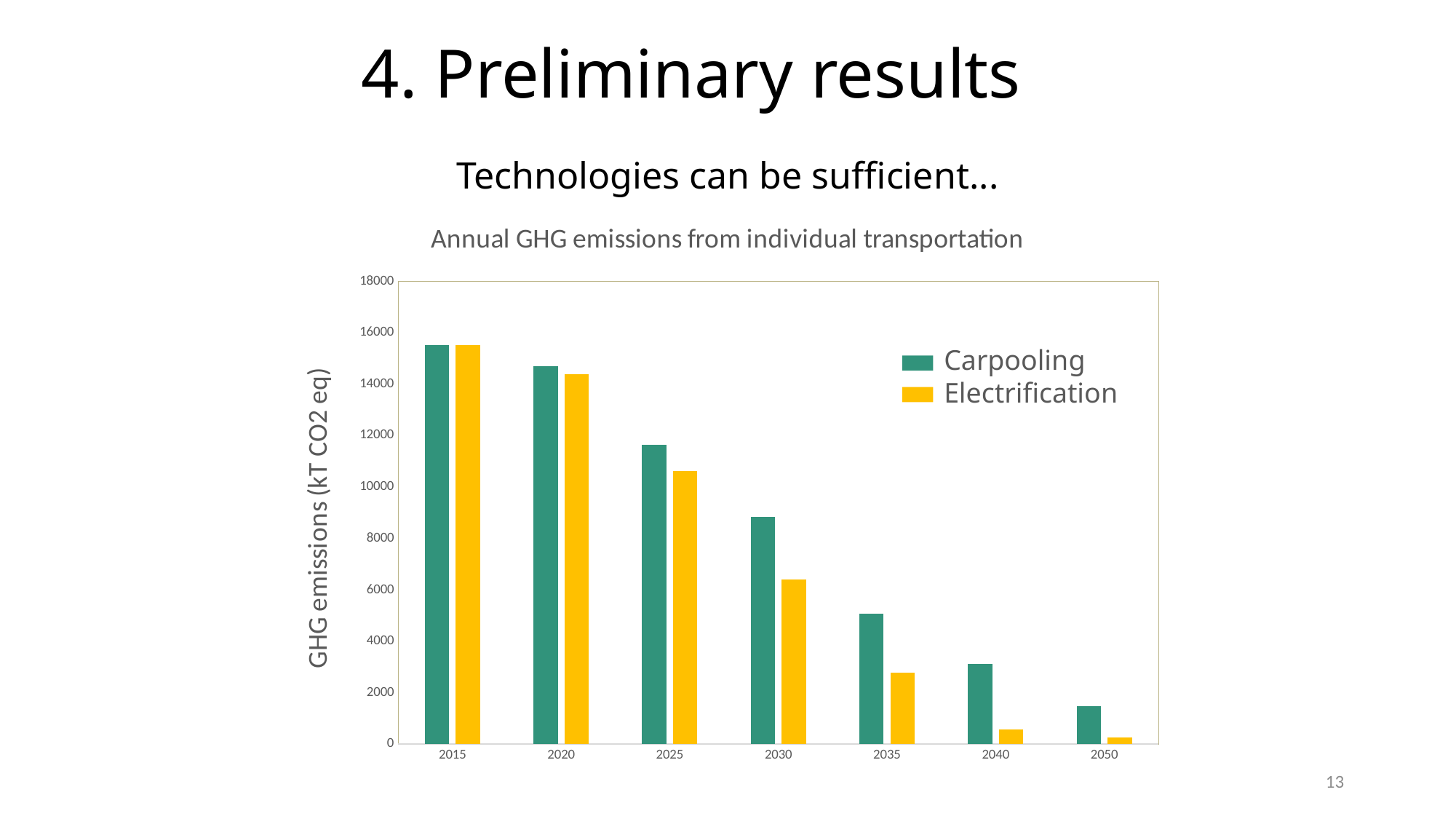
Do the Electrification values rise or fall from 2015 to 2050? fall What is the title of the chart? Annual GHG emissions from individual transportation What is the label of the y axis? GHG emissions (kT CO2 eq) Is the Electrification value for 2030 greater or less than 8000? less In 2035, which series has the larger value, Carpooling or Electrification? Carpooling Which year has the lowest Electrification value? 2050 How many series does the legend list? 2 Is the Carpooling value for 2040 greater or less than 2000? greater What type of chart is shown on the slide? bar chart Which year has the highest Carpooling value? 2015 Is the Carpooling value for 2025 greater or less than 10000? greater How many years are shown on the x axis? 7